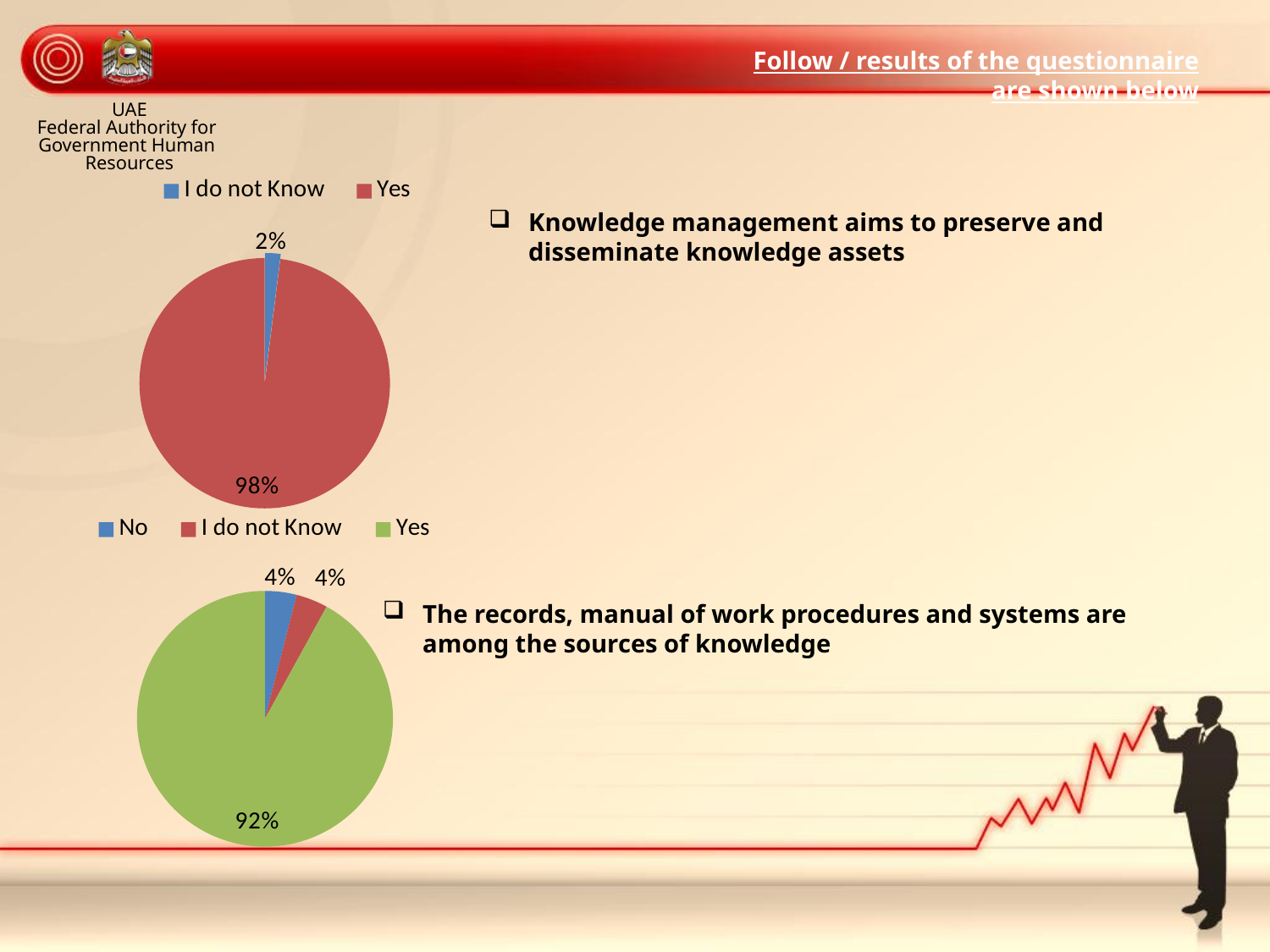
In the bottom pie chart, what share of respondents answered No? 4% What type of chart is the bottom chart on the slide? Pie chart How many slices does the top pie chart have? 2 In the bottom pie chart, which response has the largest share? Yes How many categories does the legend of the bottom pie chart list? 3 In the bottom pie chart, what share of respondents answered Yes? 92% In the top pie chart, what is the difference between the Yes share and the I do not Know share? 96% In the bottom pie chart, what is the difference between the Yes share and the No share? 88% Which is larger: the Yes share in the top pie chart or the Yes share in the bottom pie chart? The top pie chart (98%) In the top pie chart, what share of respondents answered Yes? 98% In the top pie chart, which response has the smallest share? I do not Know In the top pie chart, what share of respondents answered I do not Know? 2%